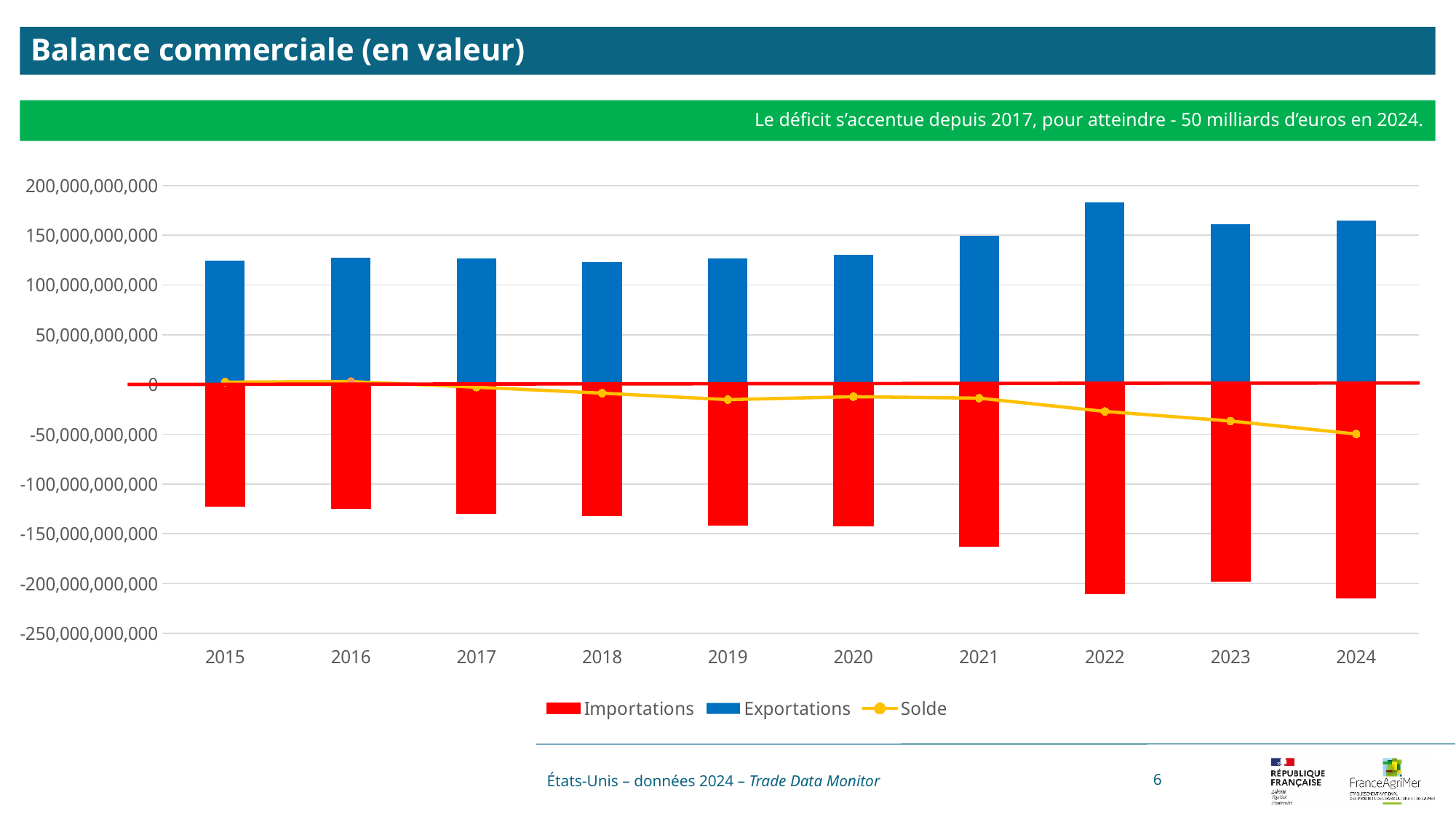
How many years are shown on the x axis of the chart? 10 How many series does the chart legend list? 3 Is the value of Exportations in 2015 greater or less than 100,000,000,000? greater Does the Solde line rise or fall from 2017 to 2024? fall Is the value of Importations in 2024 greater or less than -200,000,000,000? less What colour are the Importations bars? red Is the value of Exportations in 2022 greater or less than 150,000,000,000? greater What kind of chart is shown on the slide? bar chart with a line Which year has the larger Exportations value, 2022 or 2023? 2022 In which year are Exportations highest? 2022 Which year has the larger Exportations value, 2020 or 2021? 2021